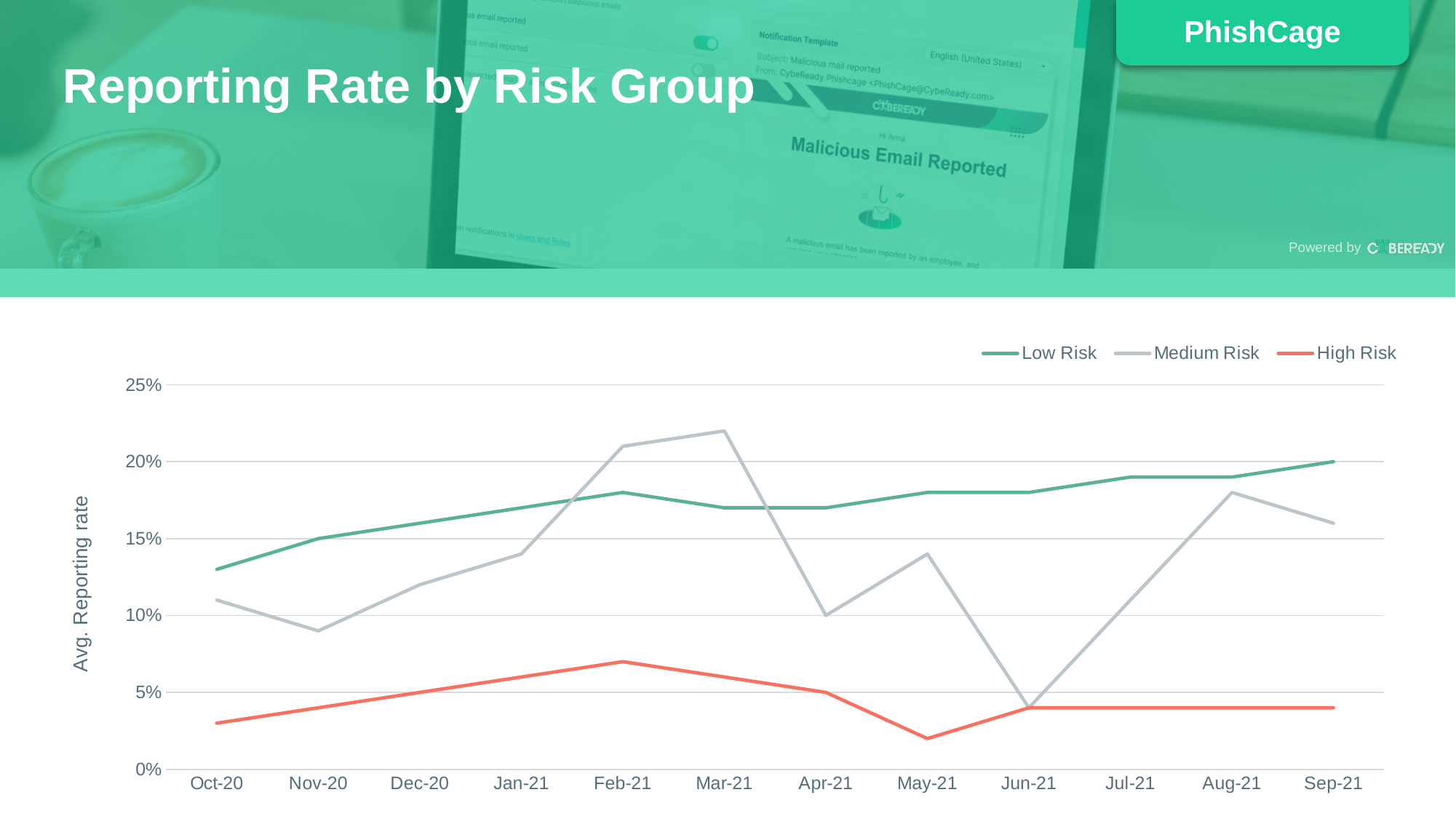
What is the Medium Risk reporting rate in Apr-21? 10% In Mar-21, which series has the higher reporting rate, Low Risk or Medium Risk? Medium Risk In which month does the Low Risk series reach its highest value? Sep-21 What kind of chart is shown on the slide? Line chart How many series does the legend list? 3 Is the Medium Risk value for Mar-21 greater or less than 20%? greater Is the High Risk value for May-21 greater or less than 5%? less How many months are plotted along the x axis? 12 What is the High Risk reporting rate in Apr-21? 5% In which month does the High Risk series reach its lowest value? May-21 What is the label on the y axis? Avg. Reporting rate What is the Low Risk reporting rate in Sep-21? 20%